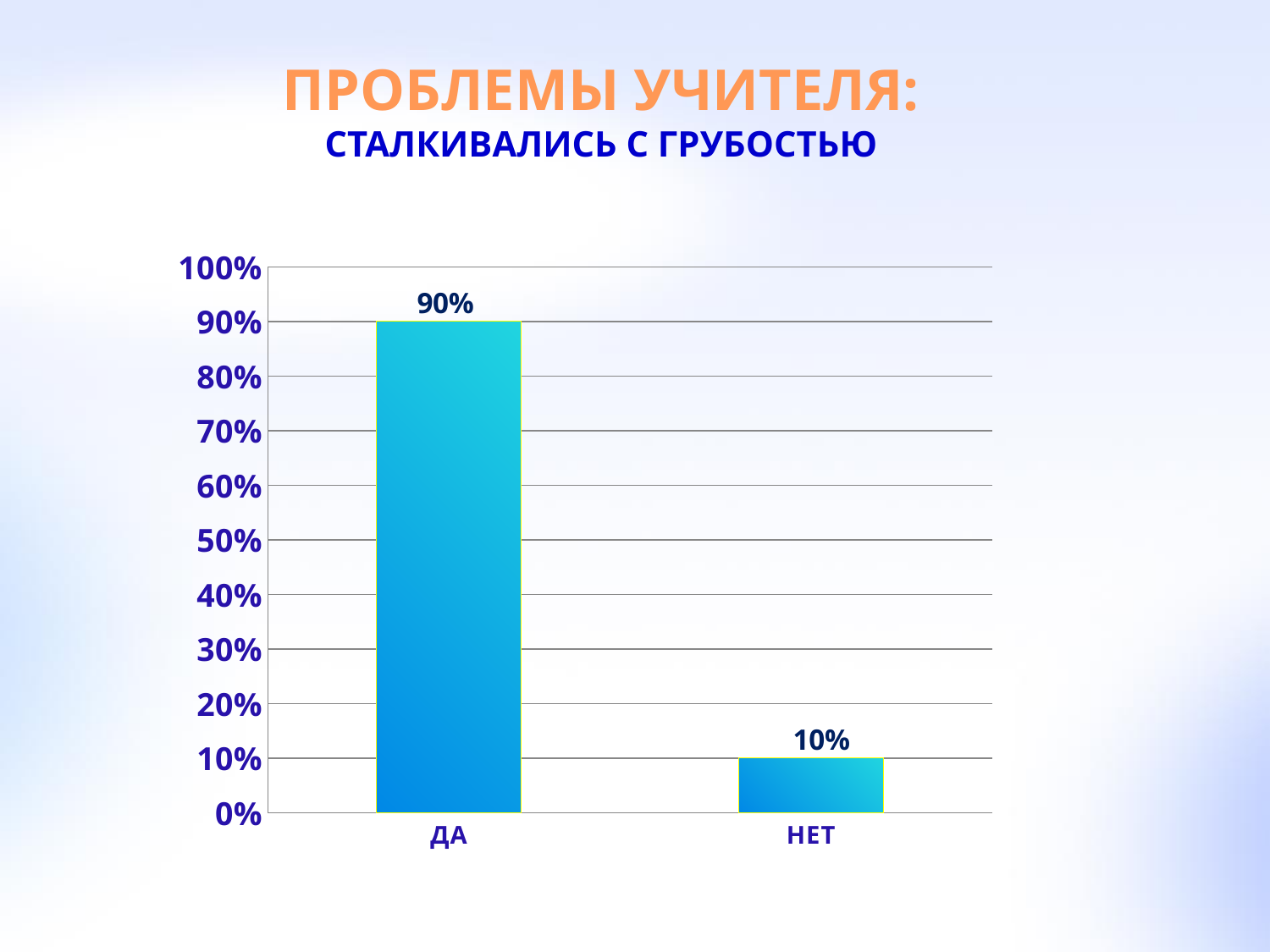
Is the value for ДА greater or less than 50%? greater What is the value for ДА? 90% What is the subtitle of the chart shown below the main title? СТАЛКИВАЛИСЬ С ГРУБОСТЬЮ Is the value for НЕТ greater or less than 20%? less Which category has the lowest value? НЕТ What is the difference between the values for ДА and НЕТ? 80% What is the value for НЕТ? 10% Which category has the highest value? ДА How many categories are shown on the x axis? 2 What kind of chart is shown on the slide? bar chart What is the maximum value shown on the y axis? 100% Which is larger, the value for ДА or the value for НЕТ? ДА